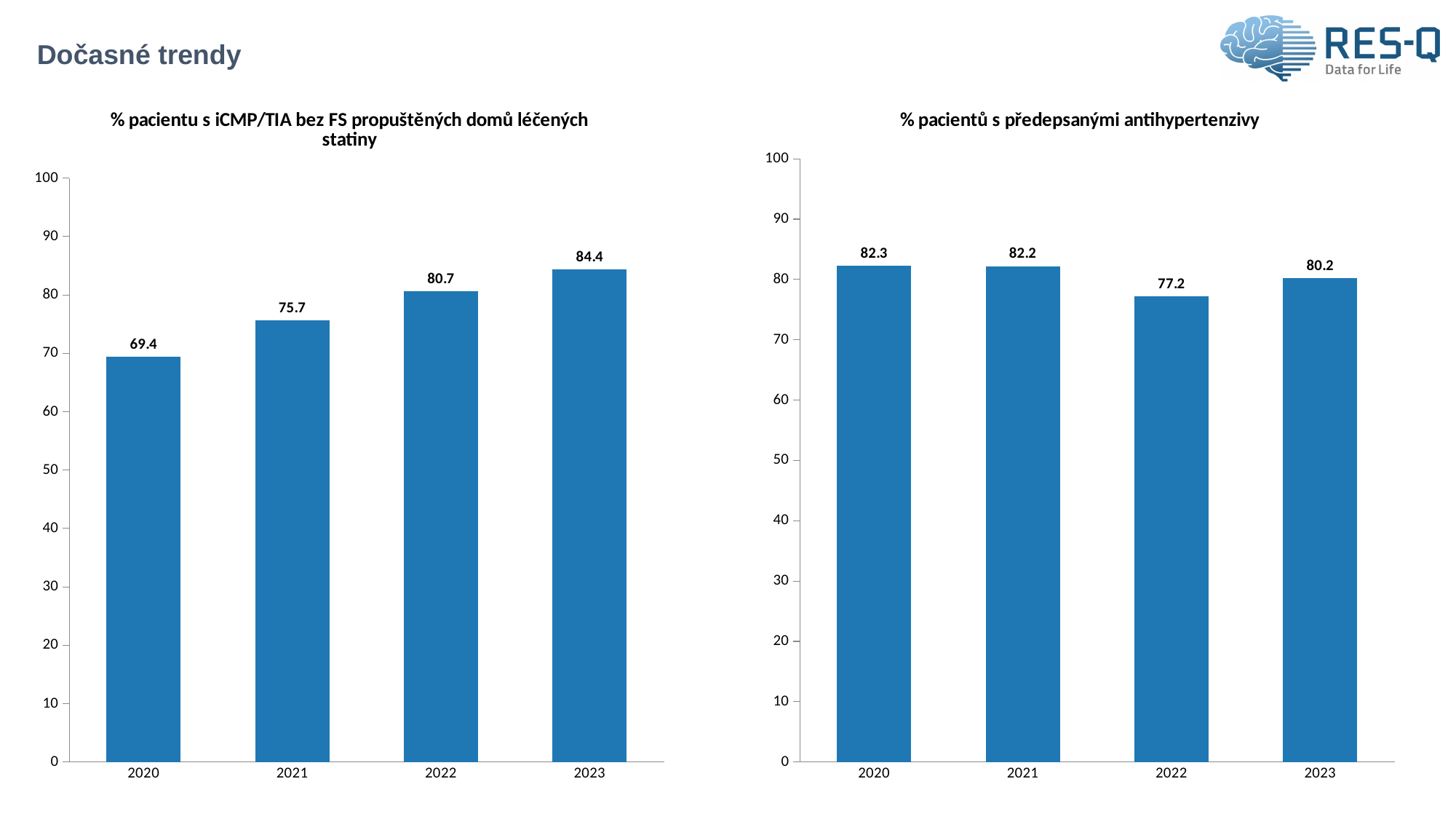
In the left chart (% pacientu s iCMP/TIA bez FS propuštěných domů léčených statiny), what is the value for 2020? 69.4 In the left chart (% pacientu s iCMP/TIA bez FS propuštěných domů léčených statiny), how many years are shown on the x axis? 4 What is the title of the right chart? % pacientů s předepsanými antihypertenzivy In the right chart (% pacientů s předepsanými antihypertenzivy), which year has the lowest value? 2022 In the right chart (% pacientů s předepsanými antihypertenzivy), what is the value for 2022? 77.2 In the left chart (% pacientu s iCMP/TIA bez FS propuštěných domů léčených statiny), which year has the highest value? 2023 In the right chart (% pacientů s předepsanými antihypertenzivy), what is the difference between the 2020 and 2022 values? 5.1 In the right chart (% pacientů s předepsanými antihypertenzivy), is the value for 2021 greater or less than 80? greater In the left chart (% pacientu s iCMP/TIA bez FS propuštěných domů léčených statiny), what is the difference between the 2023 and 2020 values? 15 What kind of chart is the left chart (% pacientu s iCMP/TIA bez FS propuštěných domů léčených statiny)? bar chart In the right chart (% pacientů s předepsanými antihypertenzivy), is the value for 2023 larger or smaller than the value for 2022? larger In the left chart (% pacientu s iCMP/TIA bez FS propuštěných domů léčených statiny), do the values rise or fall from 2020 to 2023? rise